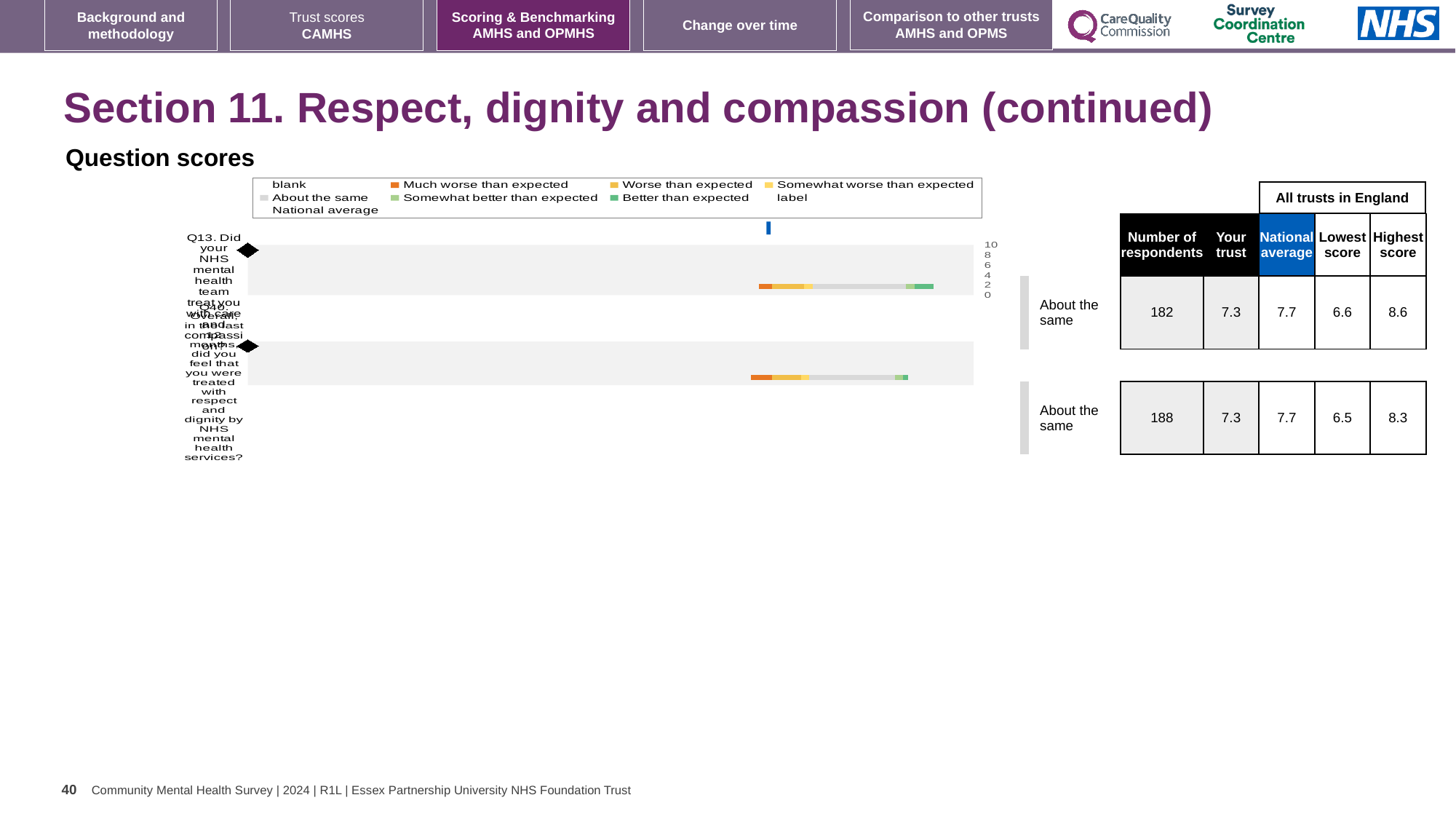
What kind of chart is used to show the question scores on this slide? bar chart What benchmark category label is shown next to both questions in the chart? About the same How many questions (categories) are plotted in the question scores chart? 2 How many entries does the legend of the question scores chart list? 9 What is the 'Your trust' score for the top question (Q13)? 7.3 What is the number of respondents for the top question (Q13) in the table? 182 What is the national average for the bottom question (Q10)? 7.7 What is the difference between the highest score and the lowest score for the top question (Q13)? 2.0 What is the highest score across all trusts in England for the top question (Q13)? 8.6 Which question has more respondents, the top question (Q13) or the bottom question (Q10)? the bottom question (Q10) What is the difference between the national average and the 'Your trust' score for the bottom question (Q10)? 0.4 What is the lowest score across all trusts in England for the bottom question (Q10)? 6.5